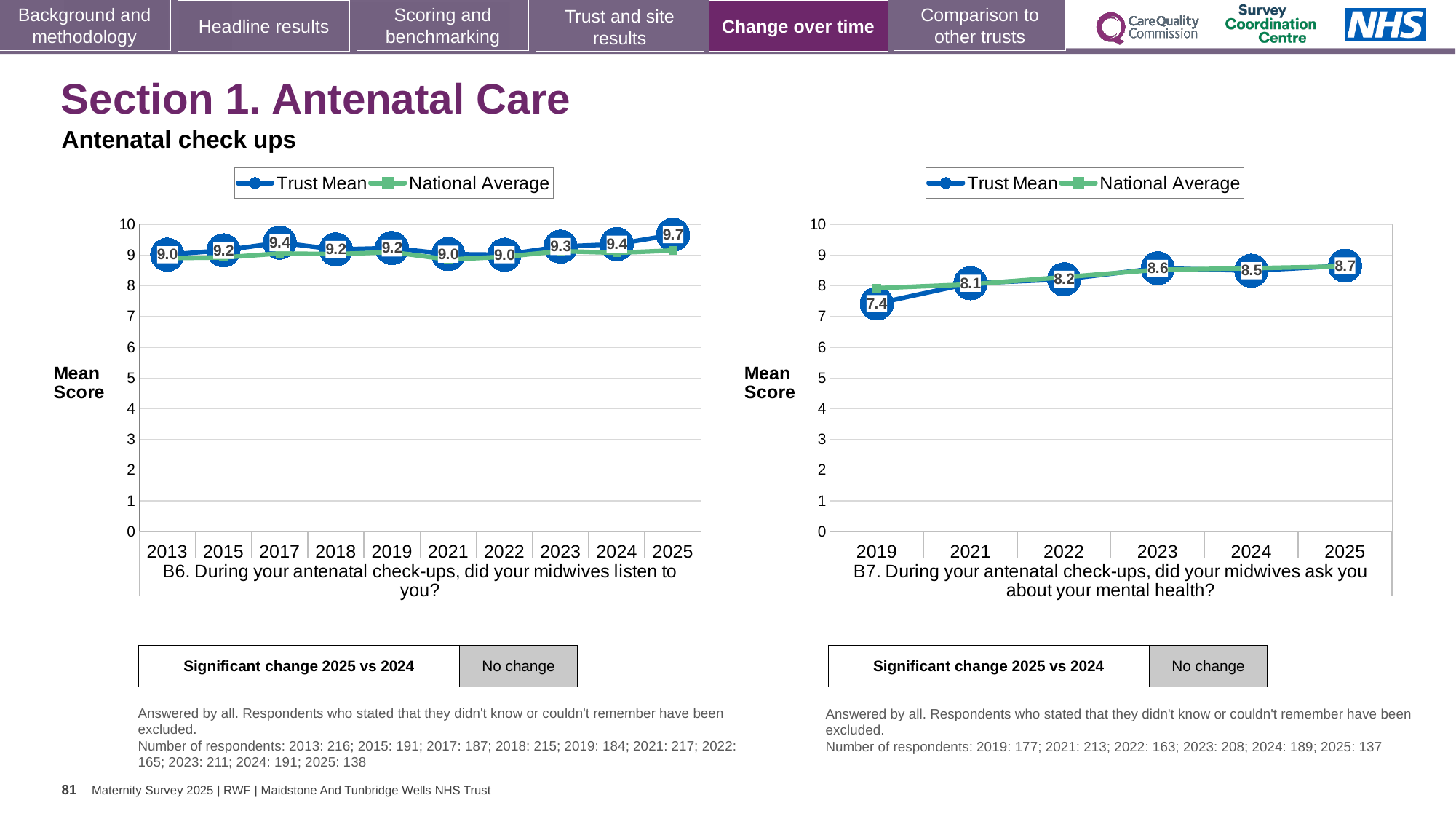
In the B7 chart (right), is the Trust Mean score for 2023 larger or smaller than for 2024? larger In the B7 chart (right), what is the Trust Mean score for 2019? 7.4 What type of chart is the B6 chart (left)? line chart In the B7 chart (right), what is the difference between the Trust Mean scores for 2025 and 2019? 1.3 In the B6 chart (left), what is the Trust Mean score for 2025? 9.7 How many series does the legend of the B7 chart (right) list? 2 In the B6 chart (left), what is the Trust Mean score for 2013? 9.0 In the B7 chart (right), does the Trust Mean score generally rise or fall from 2019 to 2025? rise In the B6 chart (left), what is the difference between the Trust Mean scores for 2025 and 2024? 0.3 In the B6 chart (left), how many years are shown on the x axis? 10 In the B6 chart (left), which year has the highest Trust Mean score? 2025 In the B7 chart (right), which year has the lowest Trust Mean score? 2019